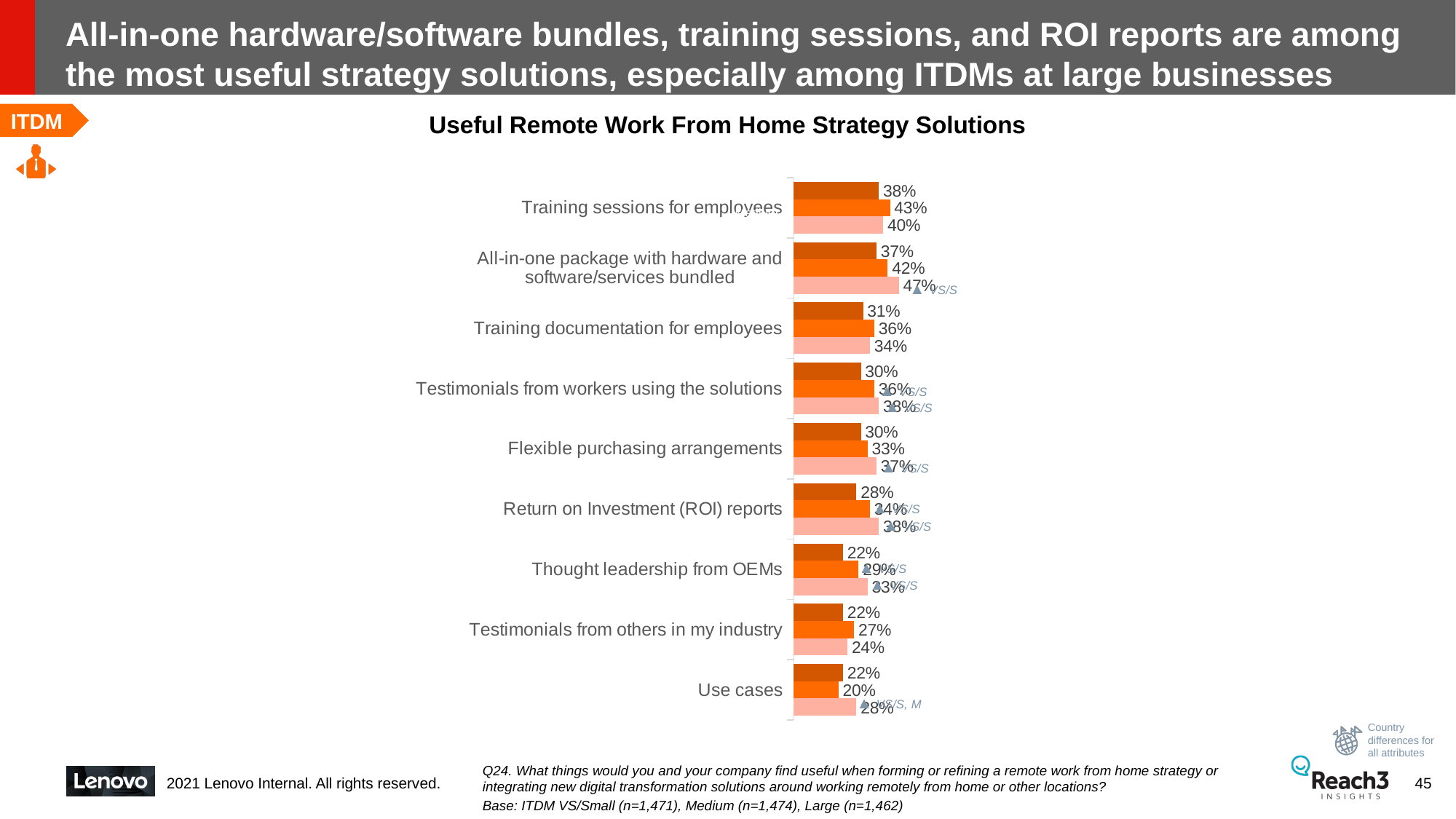
What is the value of the middle (orange) bar for "Thought leadership from OEMs"? 29% What kind of chart is shown on the slide? Bar chart For "Use cases", which is larger: the top (dark orange) bar or the middle (orange) bar? The top (dark orange) bar For "Training sessions for employees", how much larger is the middle (orange) bar than the top (dark orange) bar? 5 percentage points What is the value of the middle (orange) bar for "Use cases"? 20% What is the title of the chart? Useful Remote Work From Home Strategy Solutions For "All-in-one package with hardware and software/services bundled", what is the difference between the bottom (light pink) bar and the top (dark orange) bar? 10 percentage points What is the value of the bottom (light pink) bar for "All-in-one package with hardware and software/services bundled"? 47% Which category contains the single highest value shown on the chart? All-in-one package with hardware and software/services bundled What is the value of the top (dark orange) bar for "Training sessions for employees"? 38% How many categories are shown on the chart? 9 What is the lowest value shown on the chart? 20%